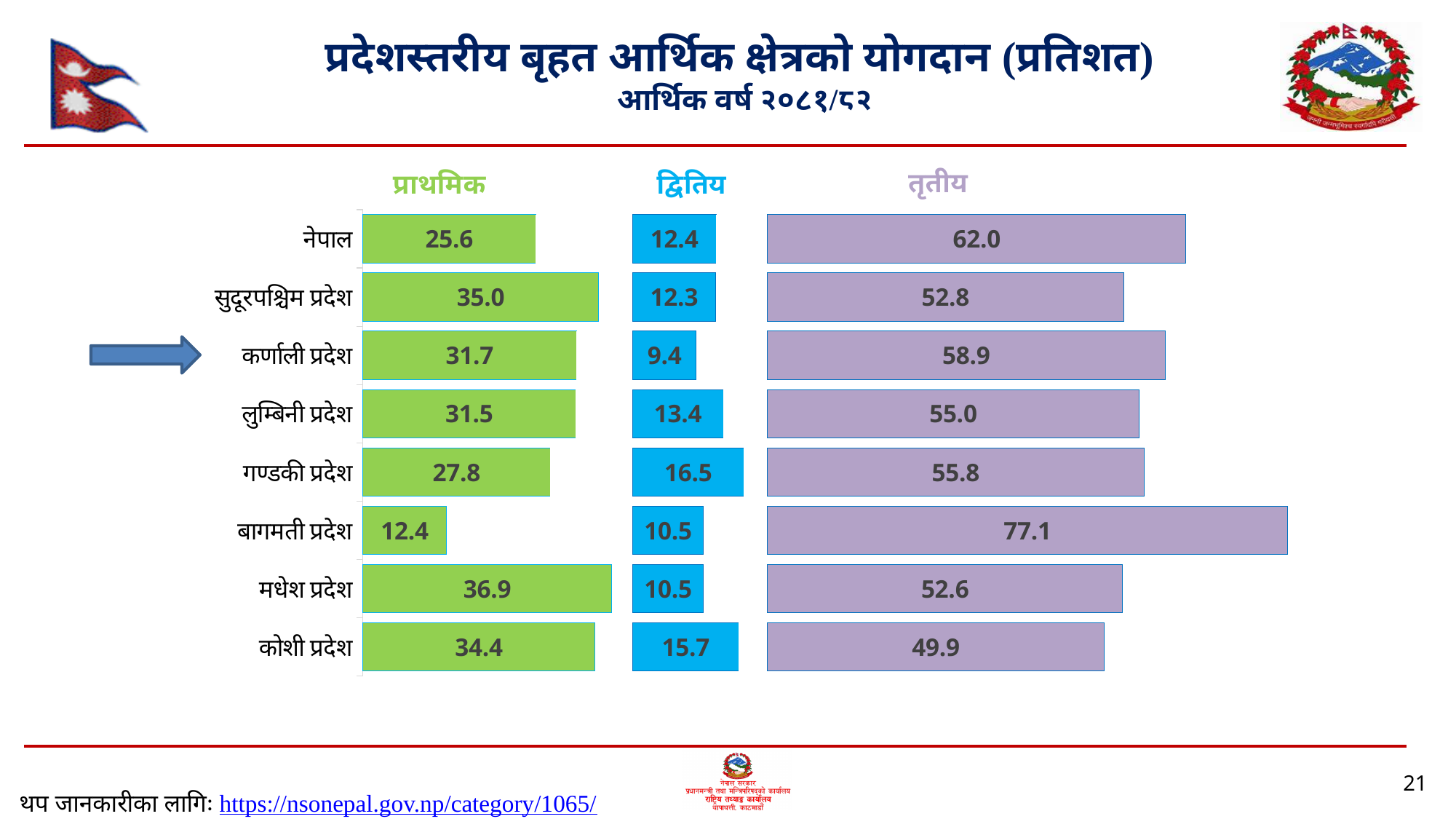
How many categories are shown on the chart? 8 What is the total of the three values for कर्णाली प्रदेश? 100.0 What is the तृतीय value for बागमती प्रदेश? 77.1 Which has the larger द्वितिय value, कोशी प्रदेश or लुम्बिनी प्रदेश? कोशी प्रदेश What is the difference between the तृतीय values for बागमती प्रदेश and नेपाल? 15.1 Which category has the highest द्वितिय value? गण्डकी प्रदेश Which category has the highest तृतीय value? बागमती प्रदेश What is the द्वितिय value for कर्णाली प्रदेश? 9.4 Which category has the lowest प्राथमिक value? बागमती प्रदेश What is the प्राथमिक value for मधेश प्रदेश? 36.9 How many series does the chart show? 3 What kind of chart is shown on the slide? bar chart